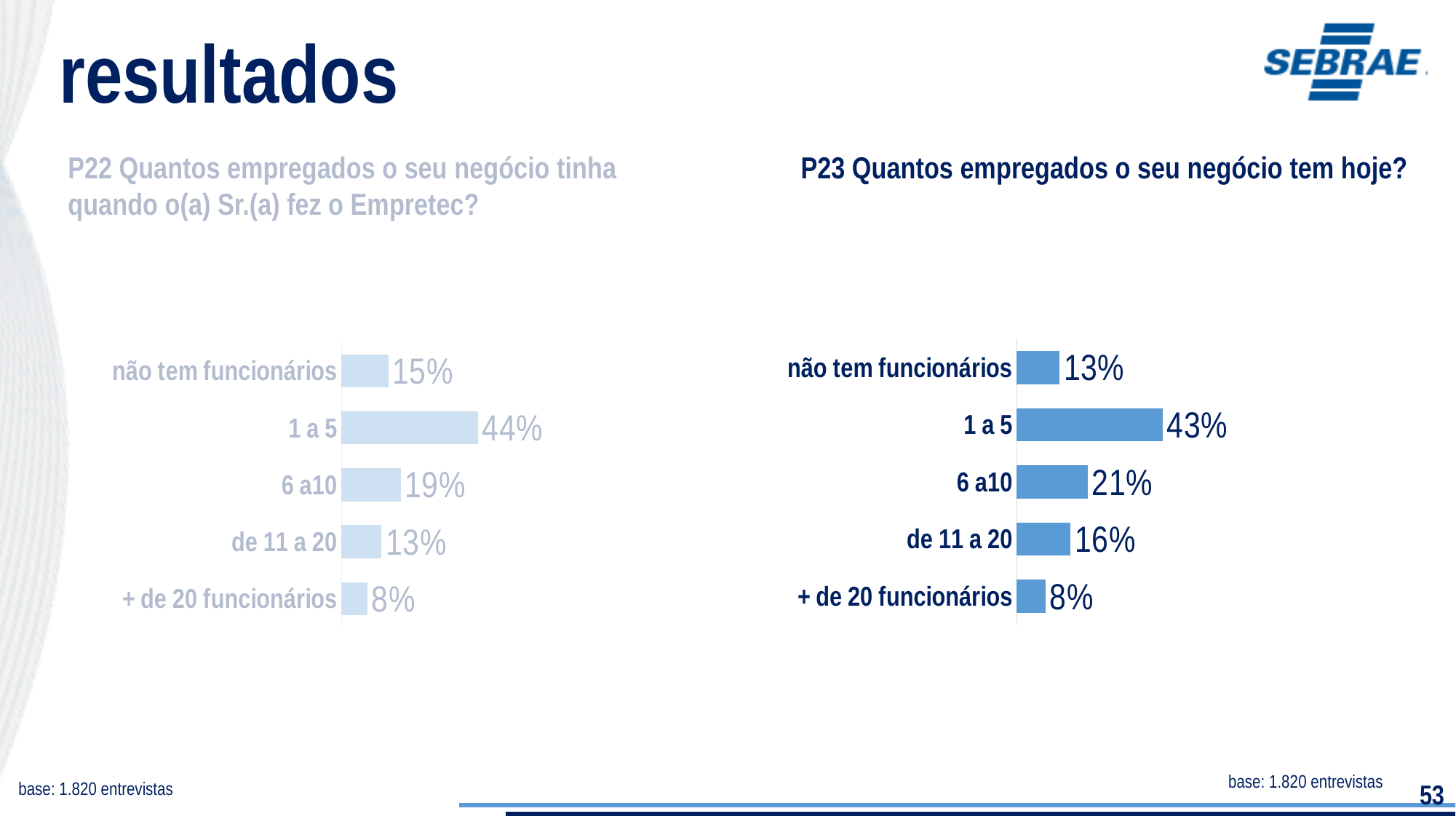
In the P22 chart on the left, which is larger: the value for 'não tem funcionários' or the value for 'de 11 a 20'? não tem funcionários In the P23 chart on the right, what is the difference between the values for '6 a10' and 'de 11 a 20'? 5% In the P23 chart on the right, what is the value for 'não tem funcionários'? 13% In the P23 chart on the right, which category has the lowest value? + de 20 funcionários In the P22 chart on the left, what is the value for '+ de 20 funcionários'? 8% What kind of chart is the P22 chart on the left? bar chart In the P23 chart on the right, what is the value for '6 a10'? 21% What is the title of the chart on the right? P23 Quantos empregados o seu negócio tem hoje? In the P22 chart on the left, what is the value for '1 a 5'? 44% In the P22 chart on the left, which category has the highest value? 1 a 5 In the P22 chart on the left, what is the difference between the values for '1 a 5' and '6 a10'? 25% How many categories does the P23 chart on the right show? 5